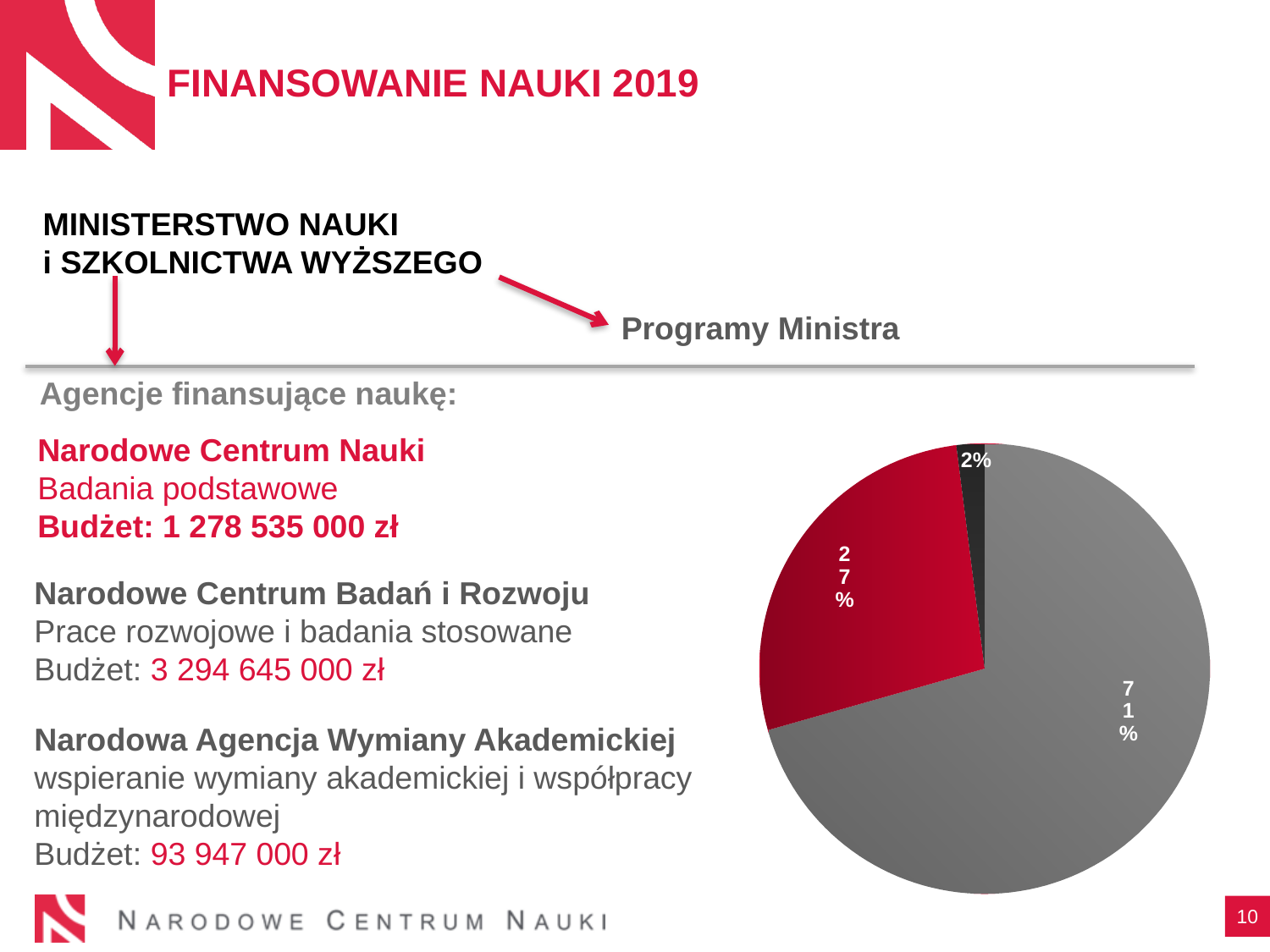
Is the grey slice greater or less than 50% of the pie? greater What kind of chart is shown on the slide? Pie chart What is the difference in percentage points between the red slice (27%) and the black slice (2%)? 25 What percentage is shown on the grey slice of the pie chart? 71% What percentage is shown on the red slice of the pie chart? 27% What is the value of the largest slice of the pie chart? 71% Which slice is larger, the red slice or the black slice? The red slice What percentage is shown on the black slice of the pie chart? 2% What is the difference in percentage points between the largest slice (71%) and the red slice (27%)? 44 How many slices does the pie chart have? 3 What colour is the largest slice of the pie chart? Grey What is the value of the smallest slice of the pie chart? 2%